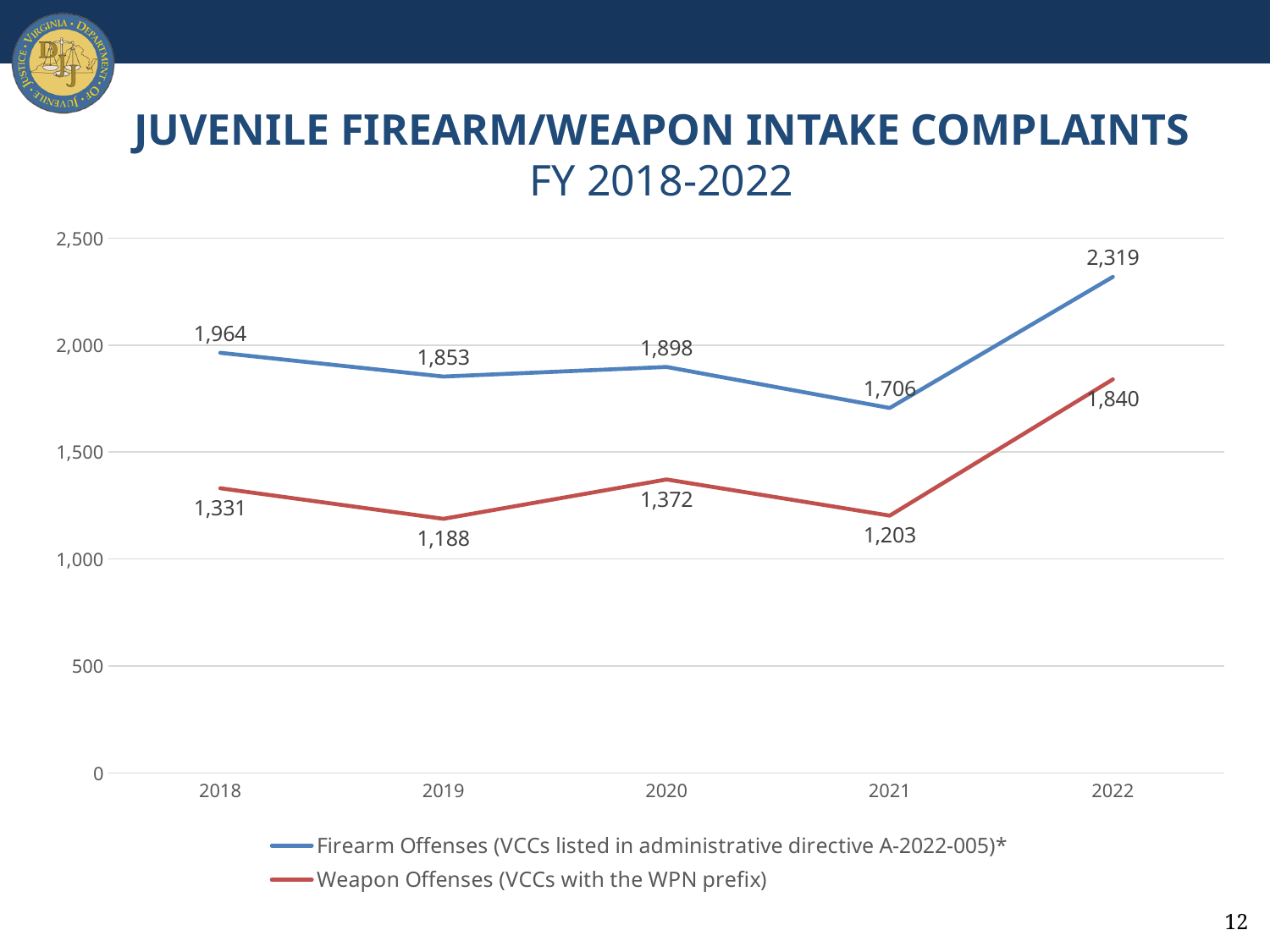
In which year is the Firearm Offenses value lowest? 2021 What is the value for Firearm Offenses in 2021? 1,706 Is the value for Firearm Offenses in 2022 greater or less than 2,000? greater How many series does the legend list? 2 What colour is the line for Weapon Offenses? Red In which year is the Weapon Offenses value highest? 2022 What kind of chart is shown on the slide? Line chart What is the difference between Firearm Offenses and Weapon Offenses in 2018? 633 Which is larger: Weapon Offenses in 2020 or Weapon Offenses in 2021? Weapon Offenses in 2020 How many years are shown on the x axis? 5 What is the value for Weapon Offenses in 2019? 1,188 What is the value for Firearm Offenses in 2022? 2,319